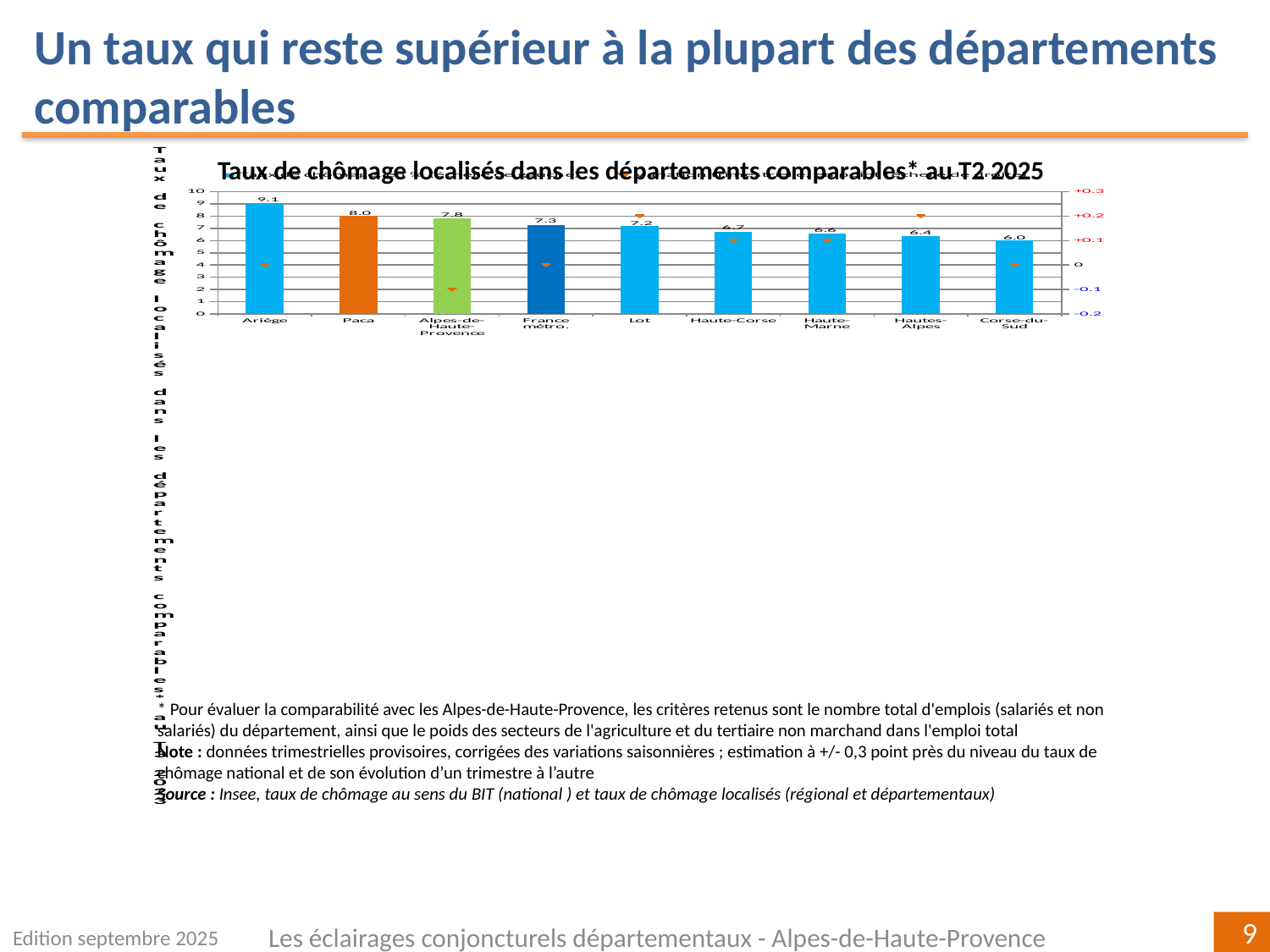
What is the unemployment rate shown for Alpes-de-Haute-Provence? 7.8 What kind of chart is this? Bar chart Which has a higher unemployment rate, Lot or Haute-Corse? Lot What is the difference between the rates for Paca and Alpes-de-Haute-Provence? 0.2 How many categories (departments/areas) are shown on the x axis? 9 What is the title of the chart? Taux de chômage localisés dans les départements comparables* au T2 2025 What is the value shown for France métro.? 7.3 What is the value shown for Corse-du-Sud? 6.0 Which category has the lowest unemployment rate? Corse-du-Sud What is the unemployment rate shown for Ariège? 9.1 Which category has the highest unemployment rate? Ariège What is the difference between the rates for Ariège and Corse-du-Sud? 3.1